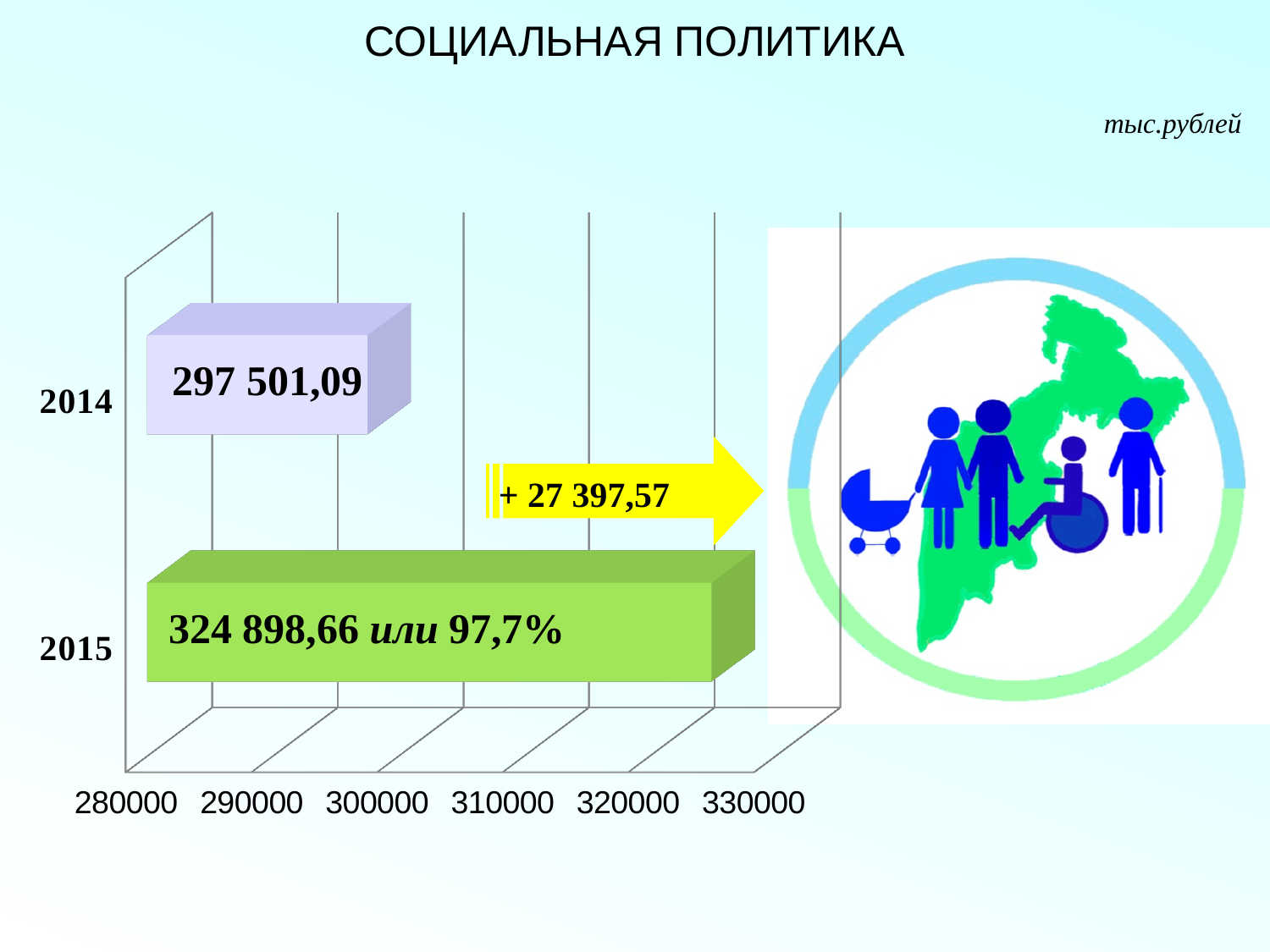
Is the value for 2014 greater or less than 300000? less What kind of chart is shown on the slide? bar chart What unit of measurement is indicated on the slide? тыс.рублей What percentage is shown next to the 2015 value? 97,7% Is the value for 2014 larger or smaller than the value for 2015? smaller How many years are shown in the chart? 2 What is the difference between the 2015 and 2014 values? 27 397,57 Is the value for 2015 greater or less than 320000? greater What is the value for 2015? 324 898,66 Which year has the higher value? 2015 What is the value for 2014? 297 501,09 Which year has the lower value? 2014